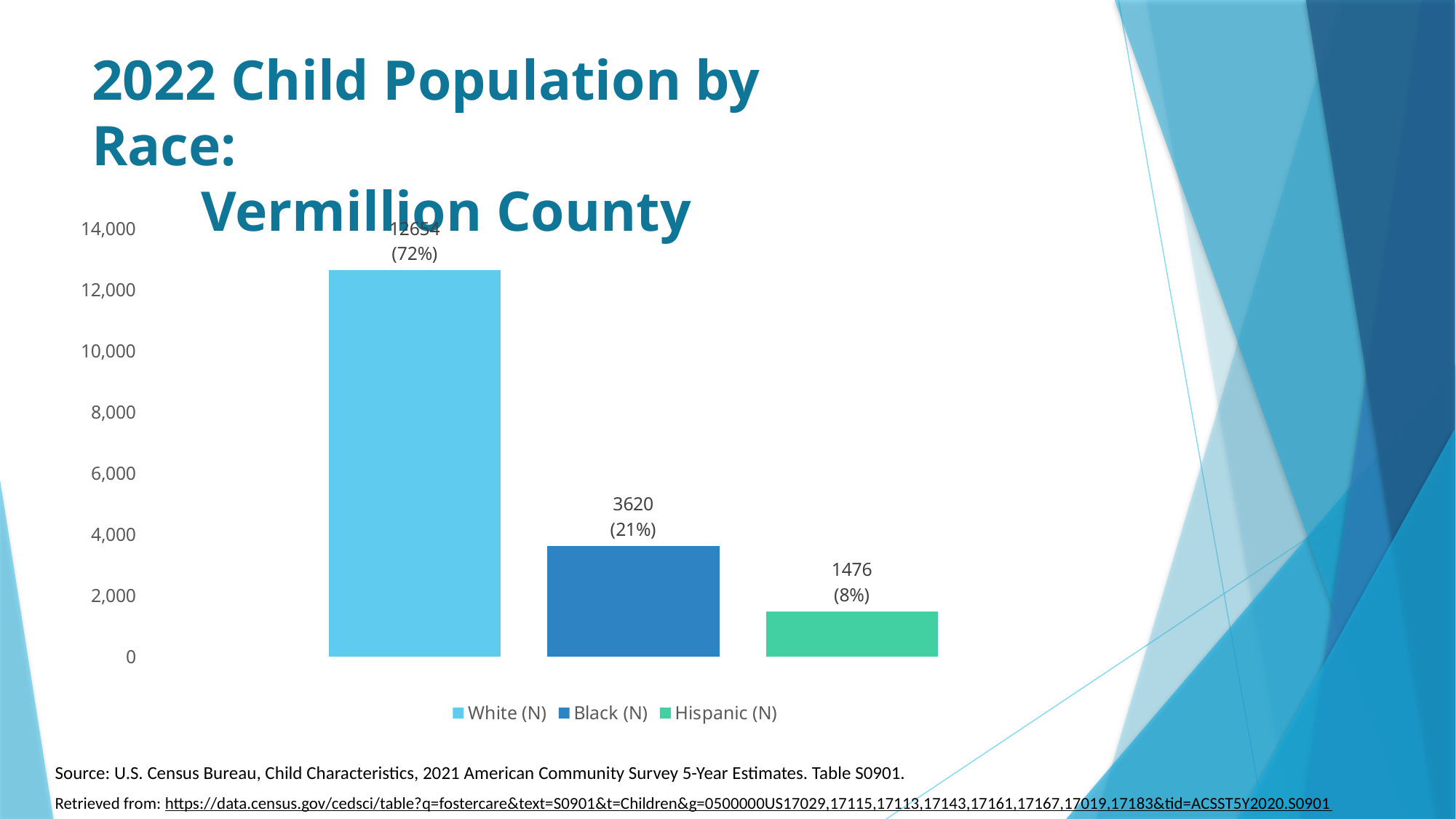
How many bars are plotted on the chart? 3 What kind of chart is shown on the slide? bar chart Is the value for White (N) greater or less than 12,000? greater What is the value for Hispanic (N)? 1476 Which category has the highest value? White (N) Which category has the lowest value? Hispanic (N) Which is larger, the value for Black (N) or the value for Hispanic (N)? Black (N) What is the value for Black (N)? 3620 What is the difference between the values for Black (N) and Hispanic (N)? 2144 What percentage is shown for Hispanic (N)? 8% What percentage is shown for White (N)? 72% What percentage is shown for Black (N)? 21%